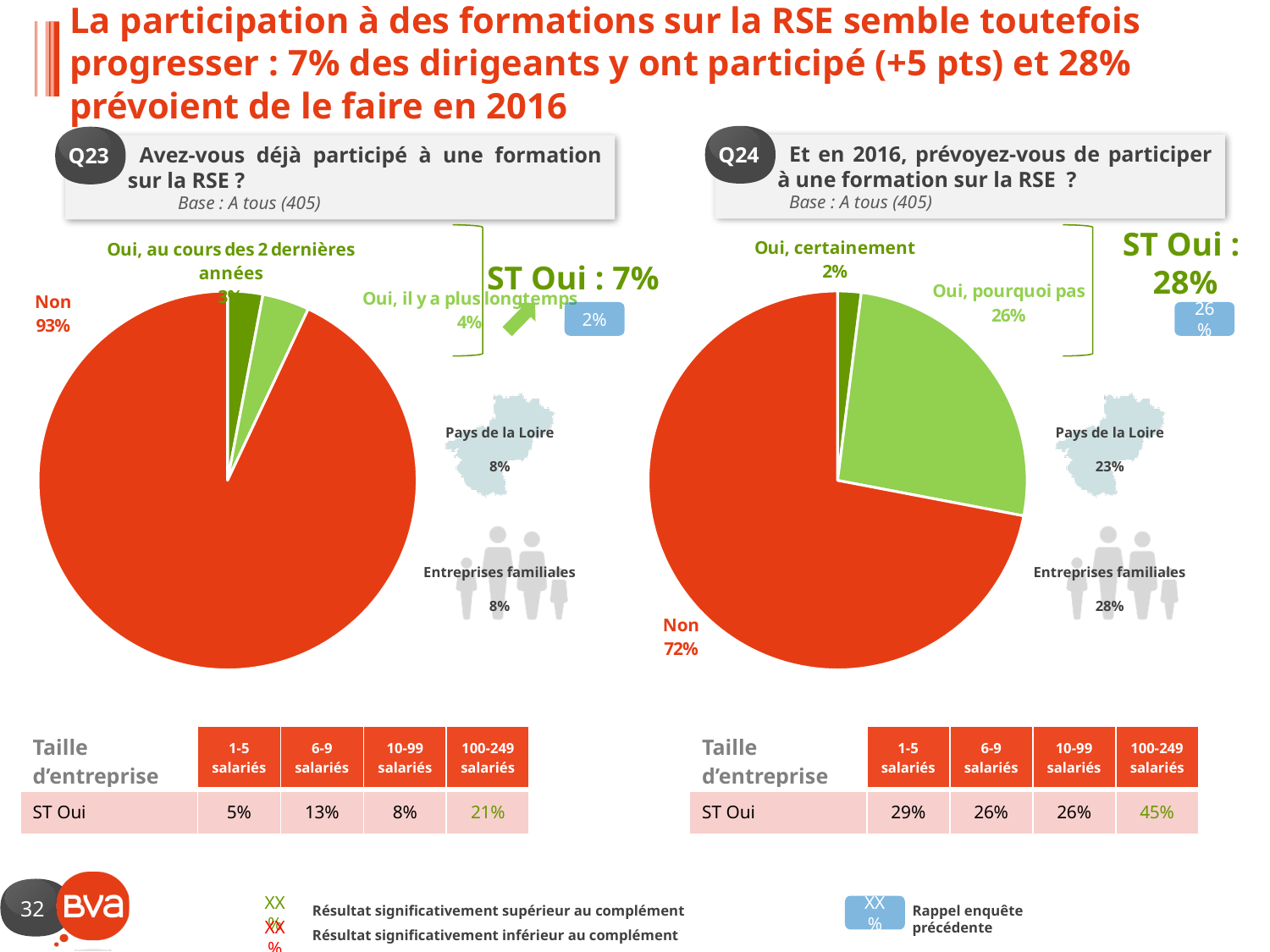
What is the "ST Oui" total shown next to the Q24 pie chart on the right? 28% What is the difference between the "Non" share in the Q23 chart (left) and the "Non" share in the Q24 chart (right)? 21 points In the Q24 pie chart on the right, which category has the largest slice? Non In the Q23 pie chart on the left, what share of respondents answered "Non"? 93% Which is larger: "Oui, pourquoi pas" in the Q24 chart or "Oui, il y a plus longtemps" in the Q23 chart? Oui, pourquoi pas In the Q23 pie chart on the left, what share answered "Oui, il y a plus longtemps"? 4% In the Q24 pie chart on the right, what share answered "Non"? 72% In the Q24 pie chart on the right, what share answered "Oui, certainement"? 2% What type of chart is used for Q23 on the left? Pie chart In the Q24 pie chart on the right, which category has the smallest slice? Oui, certainement In the Q24 pie chart on the right, what share answered "Oui, pourquoi pas"? 26% How many slices does the Q24 pie chart on the right have? 3